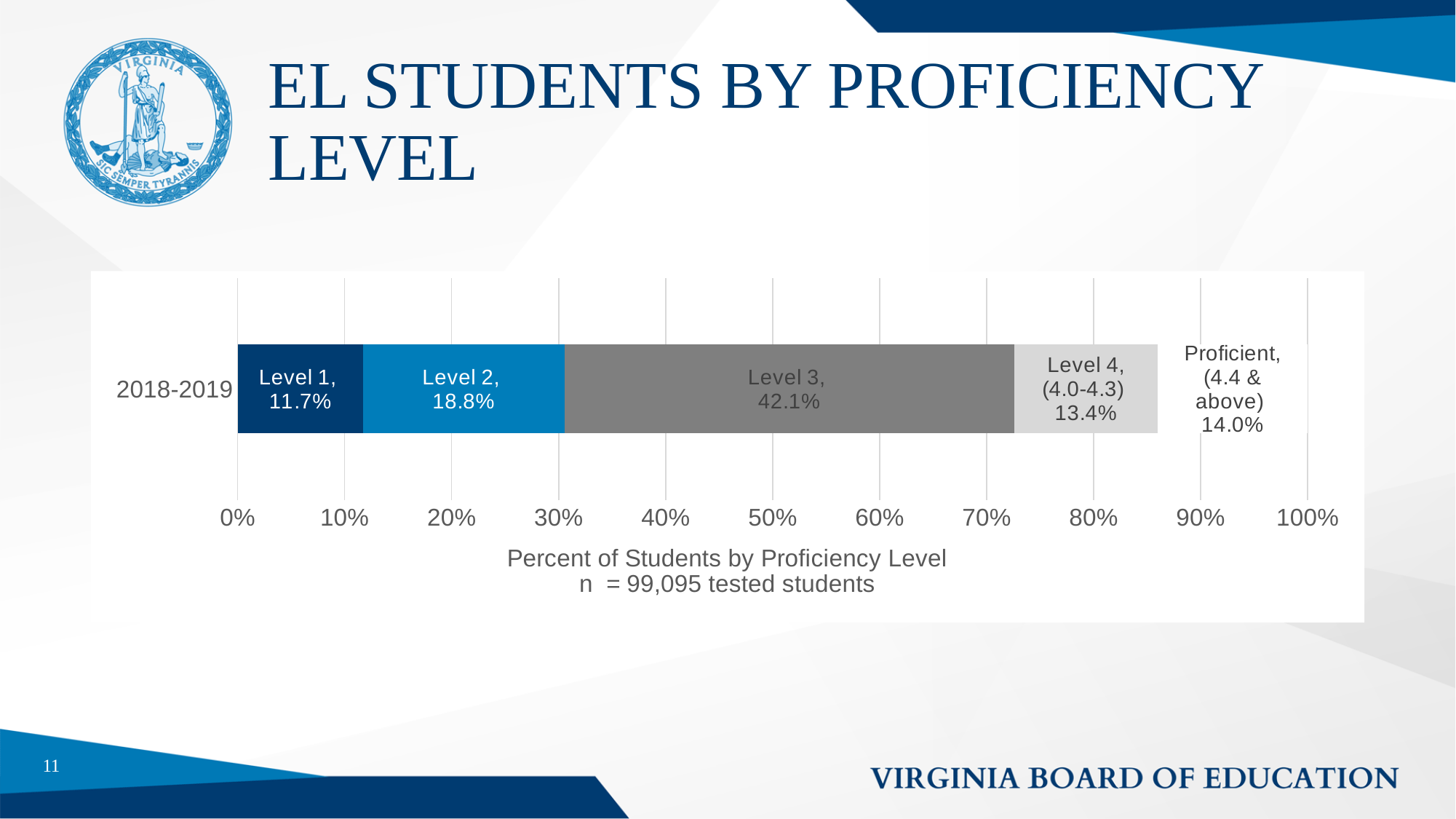
What percentage of EL students were at Level 4 (4.0-4.3) in 2018-2019? 13.4% What percentage of EL students were Proficient (4.4 & above) in 2018-2019? 14.0% What percentage of EL students were at Level 1 in 2018-2019? 11.7% What type of chart is shown on the slide? Stacked bar chart Which proficiency level has the largest share of EL students? Level 3 What percentage of EL students were at Level 3 in 2018-2019? 42.1% What is the combined percentage of Level 1 and Level 2 students? 30.5% Which proficiency level has the smallest share of EL students? Level 1 What is the difference between the Level 3 and Level 2 percentages? 23.3% How many tested students does the chart's axis label say the data is based on? 99,095 Which is larger, the Level 2 percentage or the Level 4 percentage? Level 2 How many proficiency level segments are shown in the bar? 5